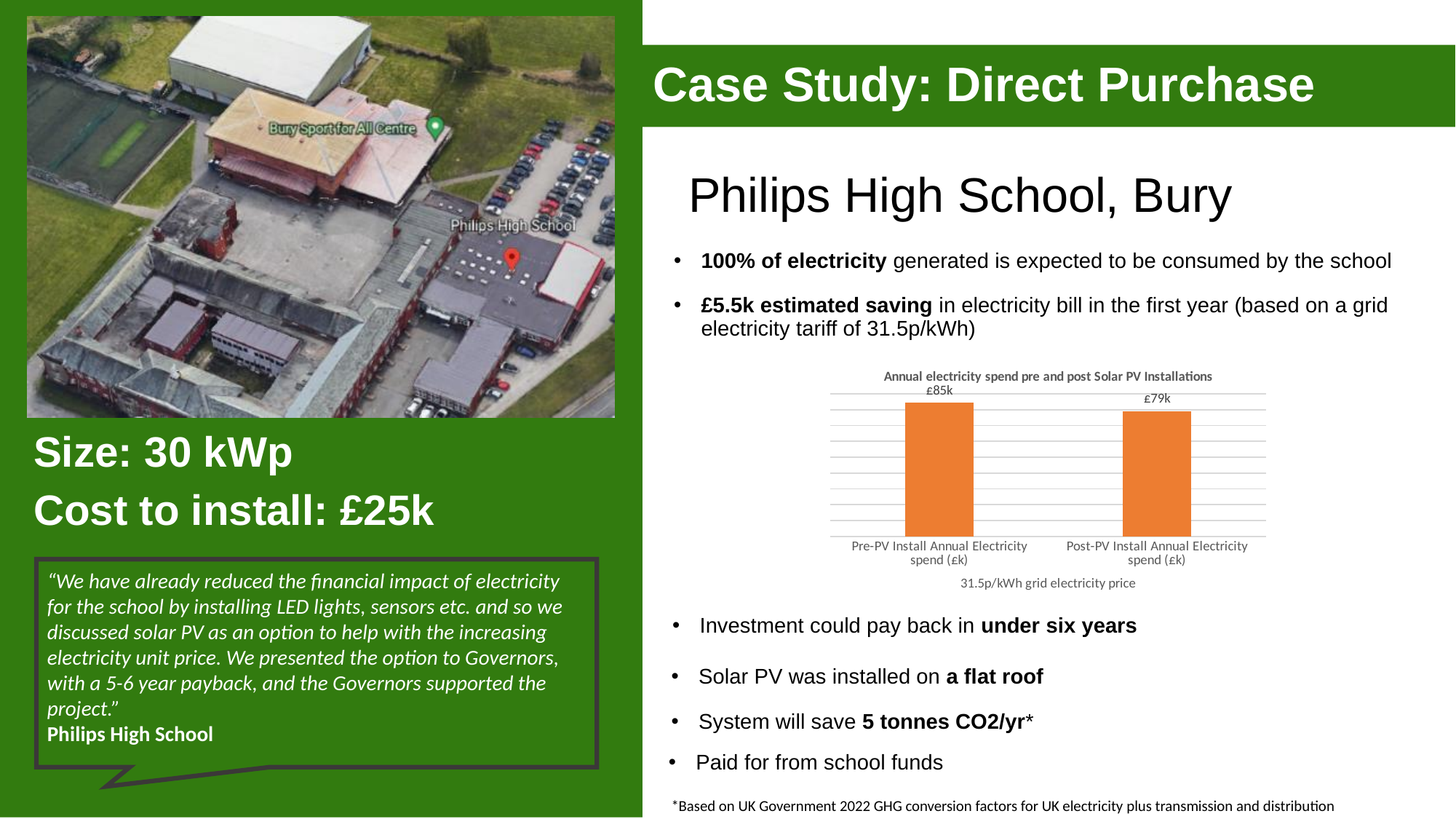
Is the Pre-PV Install annual electricity spend larger or smaller than the Post-PV Install spend? larger What kind of chart is shown on the slide? bar chart Do the values rise or fall from the Pre-PV to the Post-PV category? fall What is the value for Pre-PV Install Annual Electricity spend (£k)? £85k What grid electricity price is stated below the chart's x axis? 31.5p/kWh grid electricity price Which category has the highest annual electricity spend? Pre-PV Install Annual Electricity spend (£k) How many categories are shown in the chart? 2 What is the title of the chart? Annual electricity spend pre and post Solar PV Installations What is the difference between the Pre-PV and Post-PV annual electricity spend? £6k Which category has the lowest annual electricity spend? Post-PV Install Annual Electricity spend (£k) What is the value for Post-PV Install Annual Electricity spend (£k)? £79k